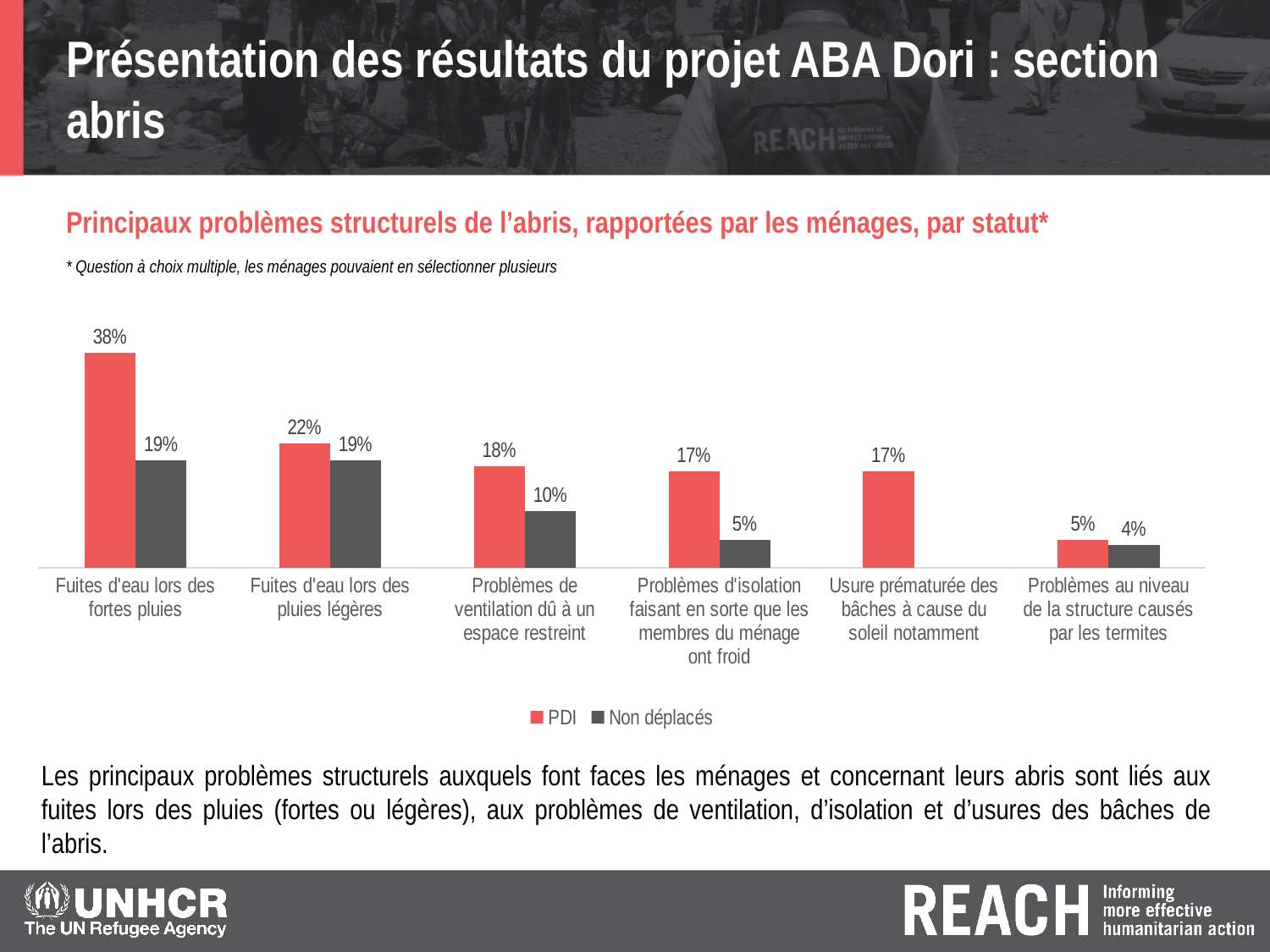
What is the Non déplacés value for "Problèmes de ventilation dû à un espace restreint"? 10% Which category has the highest PDI value? Fuites d'eau lors des fortes pluies What is the PDI value for "Usure prématurée des bâches à cause du soleil notamment"? 17% What kind of chart is shown on the slide? bar chart Which is larger for "Problèmes d'isolation faisant en sorte que les membres du ménage ont froid": the PDI value or the Non déplacés value? PDI How many categories of structural problems are shown on the x axis? 6 What is the difference between the PDI and Non déplacés values for "Fuites d'eau lors des fortes pluies"? 19% Which colour represents the PDI series in the chart? red How many series does the legend list? 2 What is the difference between the PDI values for "Fuites d'eau lors des pluies légères" and "Problèmes de ventilation dû à un espace restreint"? 4% What is the PDI value for "Fuites d'eau lors des fortes pluies"? 38% Which category has the lowest Non déplacés value among those with a labelled bar? Problèmes au niveau de la structure causés par les termites